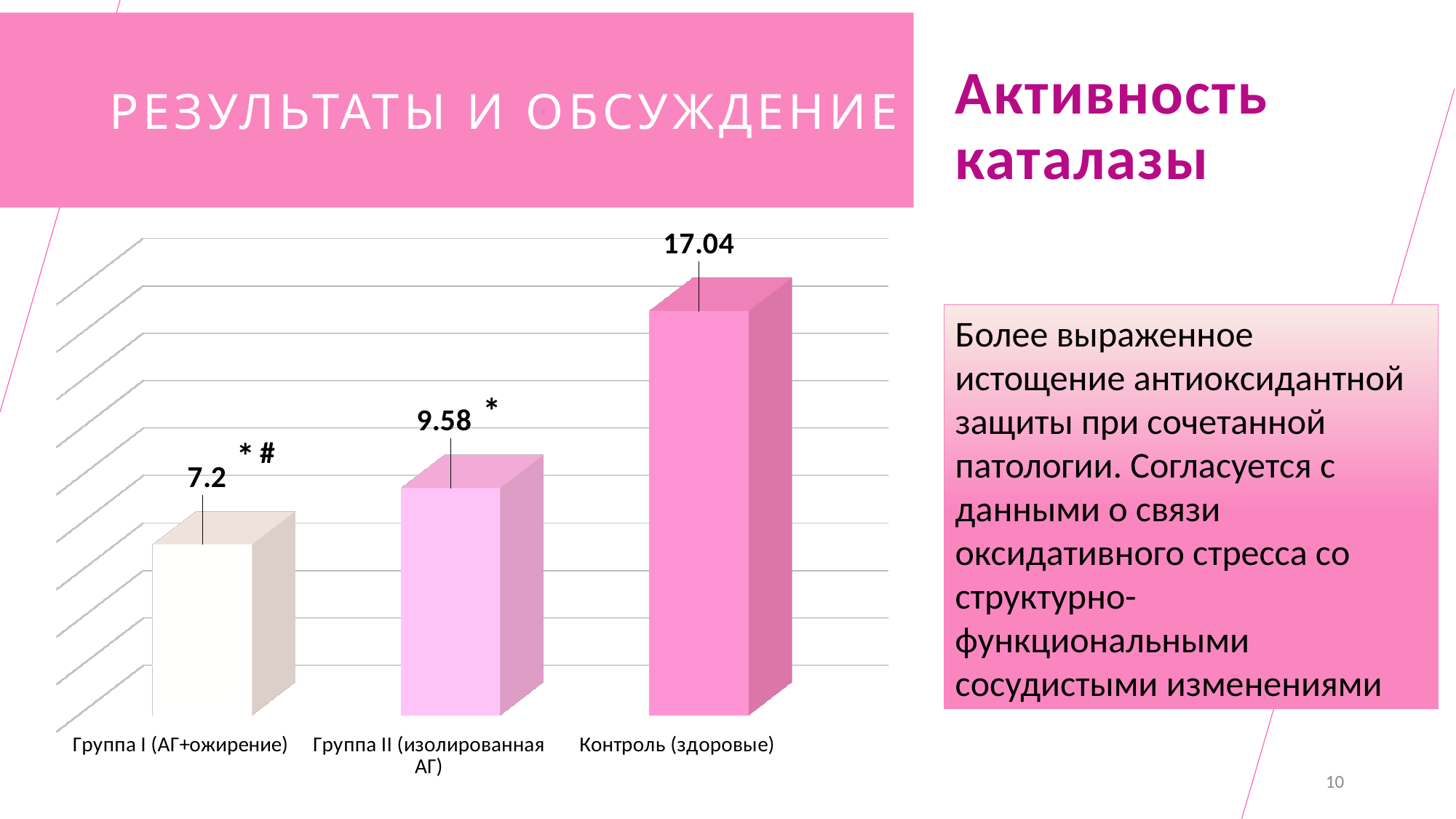
Which category has the lowest value? Группа I (АГ+ожирение) Do the values rise or fall from left to right across the categories? Rise What is the value for Группа I (АГ+ожирение)? 7.2 How many categories are shown in the chart? 3 What is the value for Группа II (изолированная АГ)? 9.58 What kind of chart is shown on the slide? Bar chart Which is larger, the value for Группа II (изолированная АГ) or the value for Контроль (здоровые)? Контроль (здоровые) What is the value for Контроль (здоровые)? 17.04 What is the difference between the values for Контроль (здоровые) and Группа I (АГ+ожирение)? 9.84 Which category has the highest value? Контроль (здоровые) What is the title of the chart on the slide? Активность каталазы What is the difference between the values for Группа II (изолированная АГ) and Группа I (АГ+ожирение)? 2.38